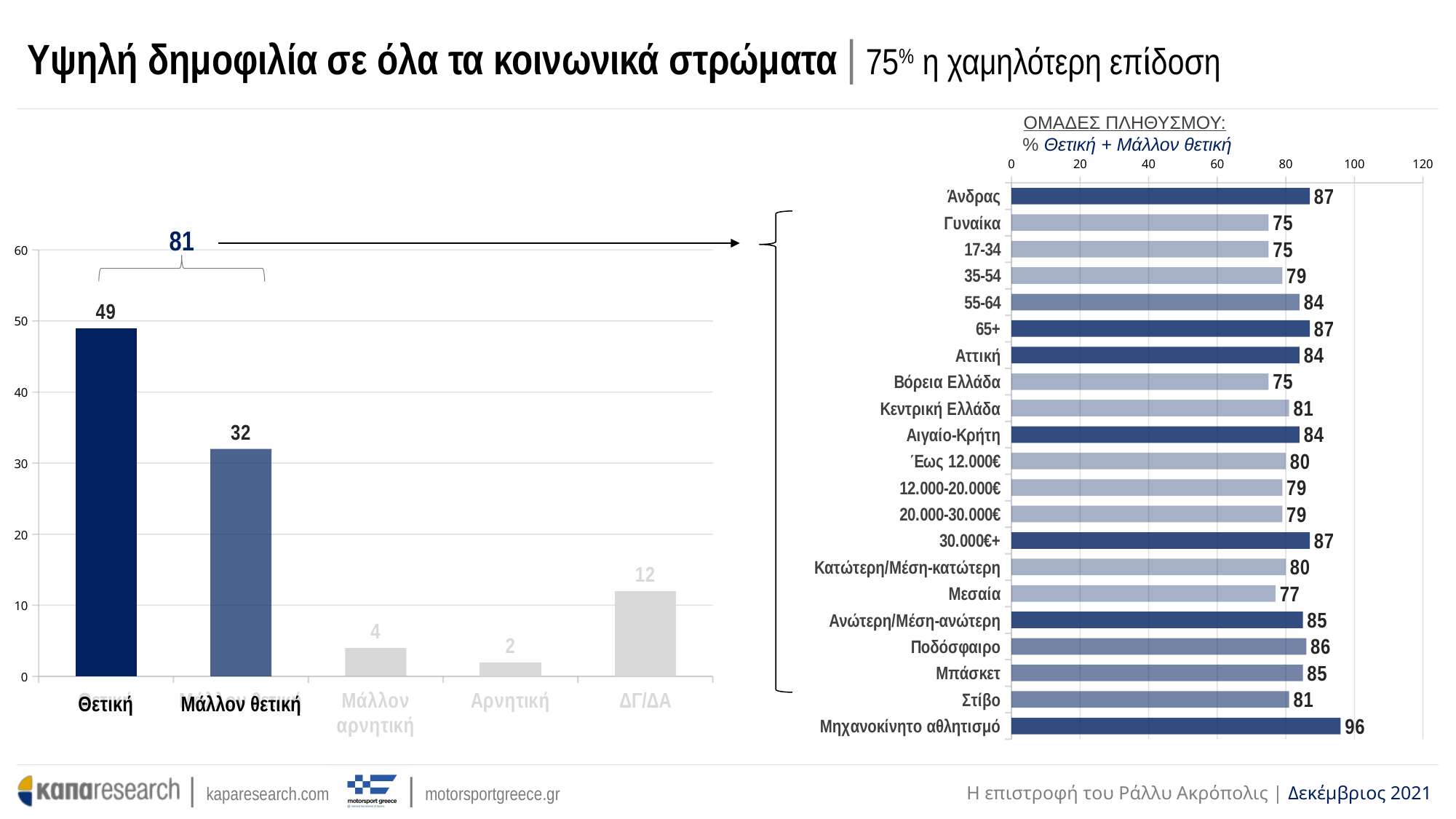
In the right chart (ΟΜΑΔΕΣ ΠΛΗΘΥΣΜΟΥ), what is the value for Μεσαία? 77 In the left bar chart, what is the combined value of Θετική and Μάλλον θετική shown above the bracket? 81 In the left bar chart, what is the difference between Θετική and Μάλλον θετική? 17 In the left bar chart, which category has the lowest value? Αρνητική In the left bar chart, how many categories are shown? 5 In the right chart (ΟΜΑΔΕΣ ΠΛΗΘΥΣΜΟΥ), which is larger, Άνδρας or Γυναίκα? Άνδρας In the right chart (ΟΜΑΔΕΣ ΠΛΗΘΥΣΜΟΥ), which category has the highest value? Μηχανοκίνητο αθλητισμό In the right chart (ΟΜΑΔΕΣ ΠΛΗΘΥΣΜΟΥ), what is the difference between 30.000€+ and Έως 12.000€? 7 In the left bar chart, what is the value for Θετική? 49 In the left bar chart, what is the value for ΔΓ/ΔΑ? 12 What kind of chart is the right chart (ΟΜΑΔΕΣ ΠΛΗΘΥΣΜΟΥ)? Bar chart In the right chart (ΟΜΑΔΕΣ ΠΛΗΘΥΣΜΟΥ), what is the value for Μηχανοκίνητο αθλητισμό? 96